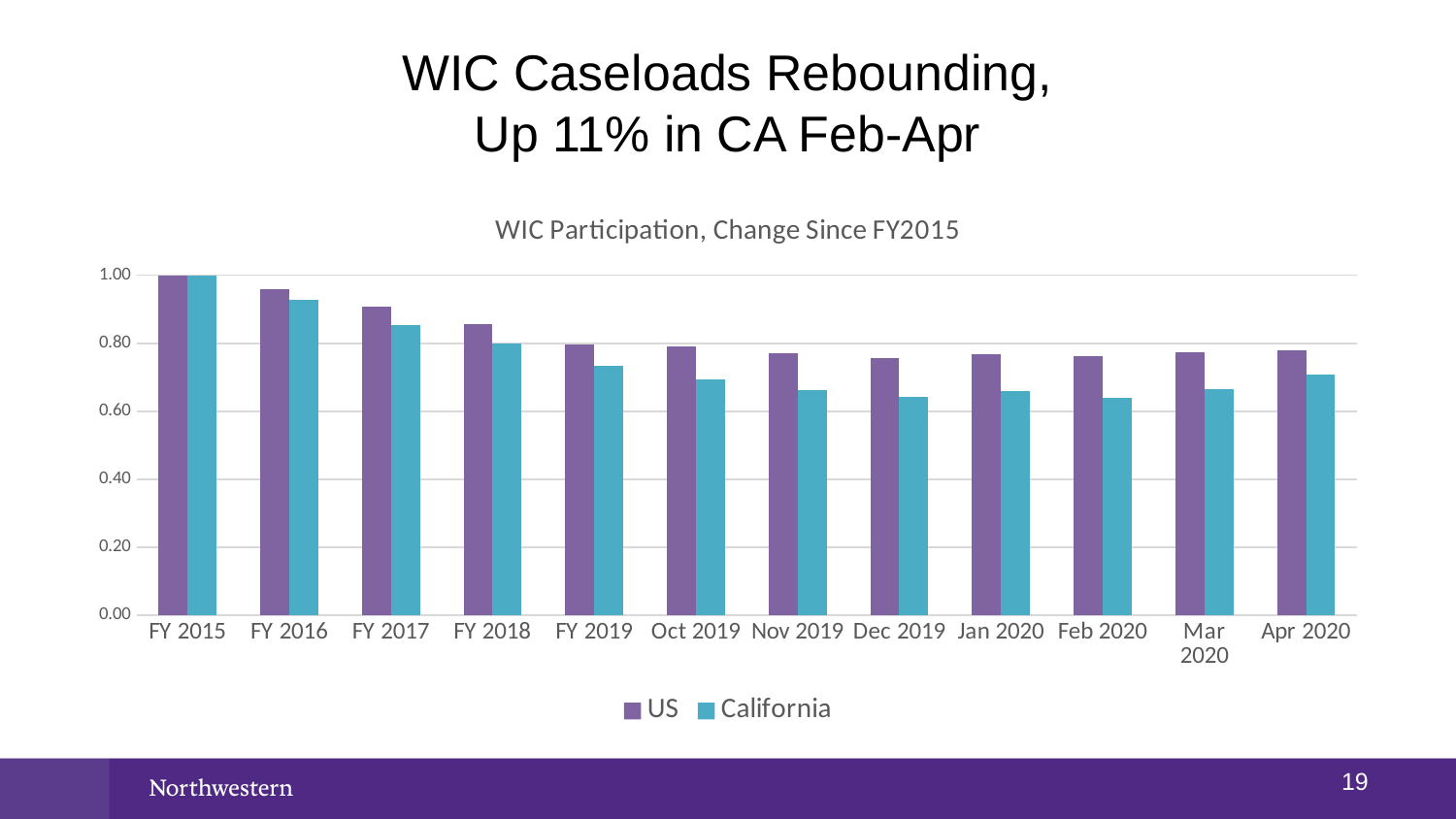
Is the value for US in FY 2016 greater or less than 0.80? greater What is the value for California in FY 2015? 1.00 How many series does the legend list? 2 What kind of chart is shown on the slide? bar chart What is the value for US in FY 2015? 1.00 In Apr 2020, which is larger, the US value or the California value? US How many categories are shown along the x axis? 12 Is the value for US in Dec 2019 greater or less than 0.60? greater What is the title of the chart? WIC Participation, Change Since FY2015 Is the value for California in FY 2019 greater or less than 0.80? less Which category has the highest value for California? FY 2015 Do the US values rise or fall from FY 2015 to FY 2019? fall